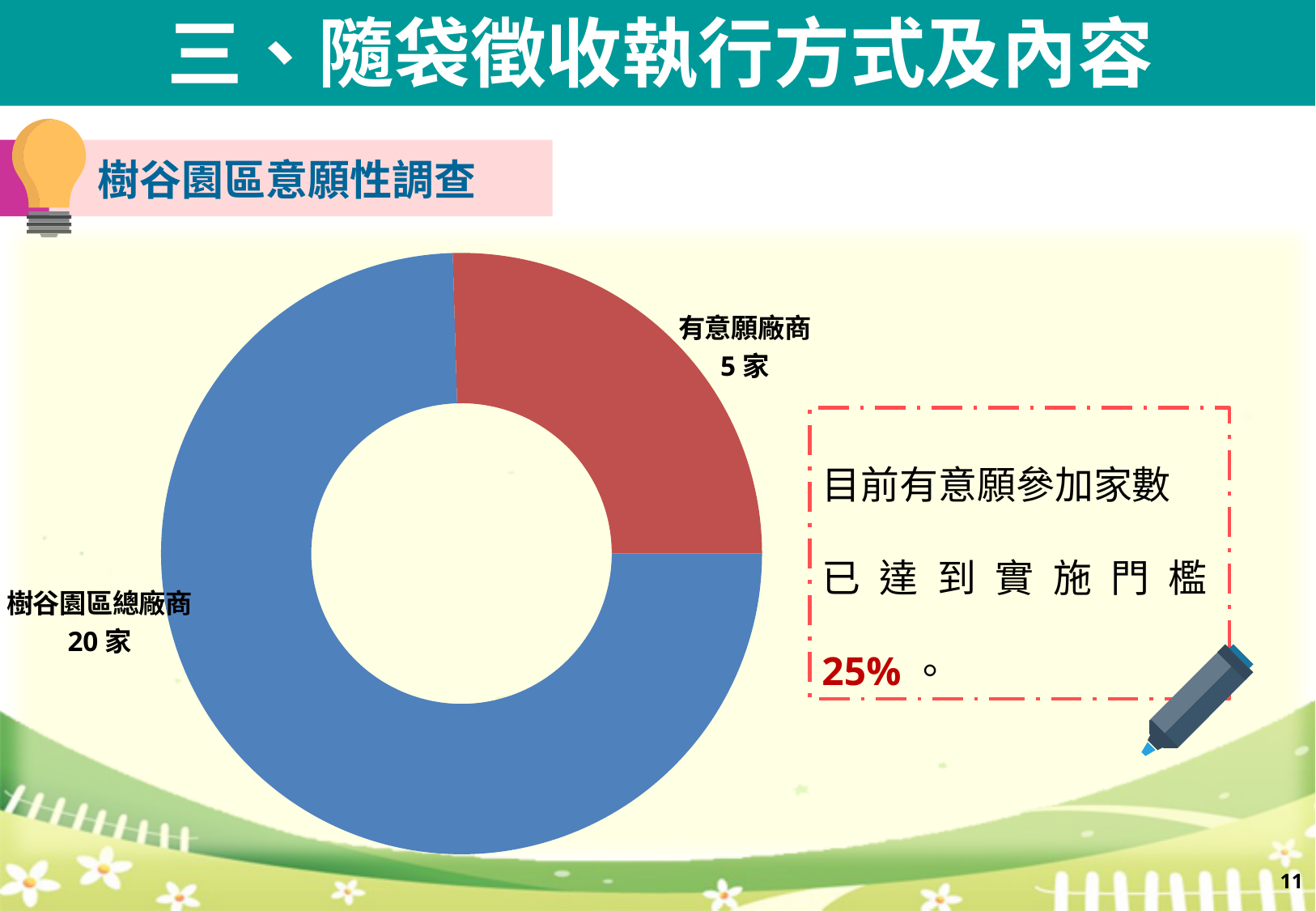
What is the heading shown above the chart? 樹谷園區意願性調查 What colour is the segment for 有意願廠商? Red What is the value shown for 樹谷園區總廠商? 20 家 What kind of chart is shown on the slide? Doughnut (pie) chart Is the value for 有意願廠商 larger or smaller than the value for 樹谷園區總廠商? Smaller Which segment of the chart has the larger value? 樹谷園區總廠商 Which segment of the chart has the smaller value? 有意願廠商 What is the value shown for 有意願廠商? 5 家 How many segments does the chart have? 2 What is the difference between the value for 樹谷園區總廠商 and the value for 有意願廠商? 15 家 What share of the 20 total factories do the 5 willing factories represent, as stated on the slide? 25%